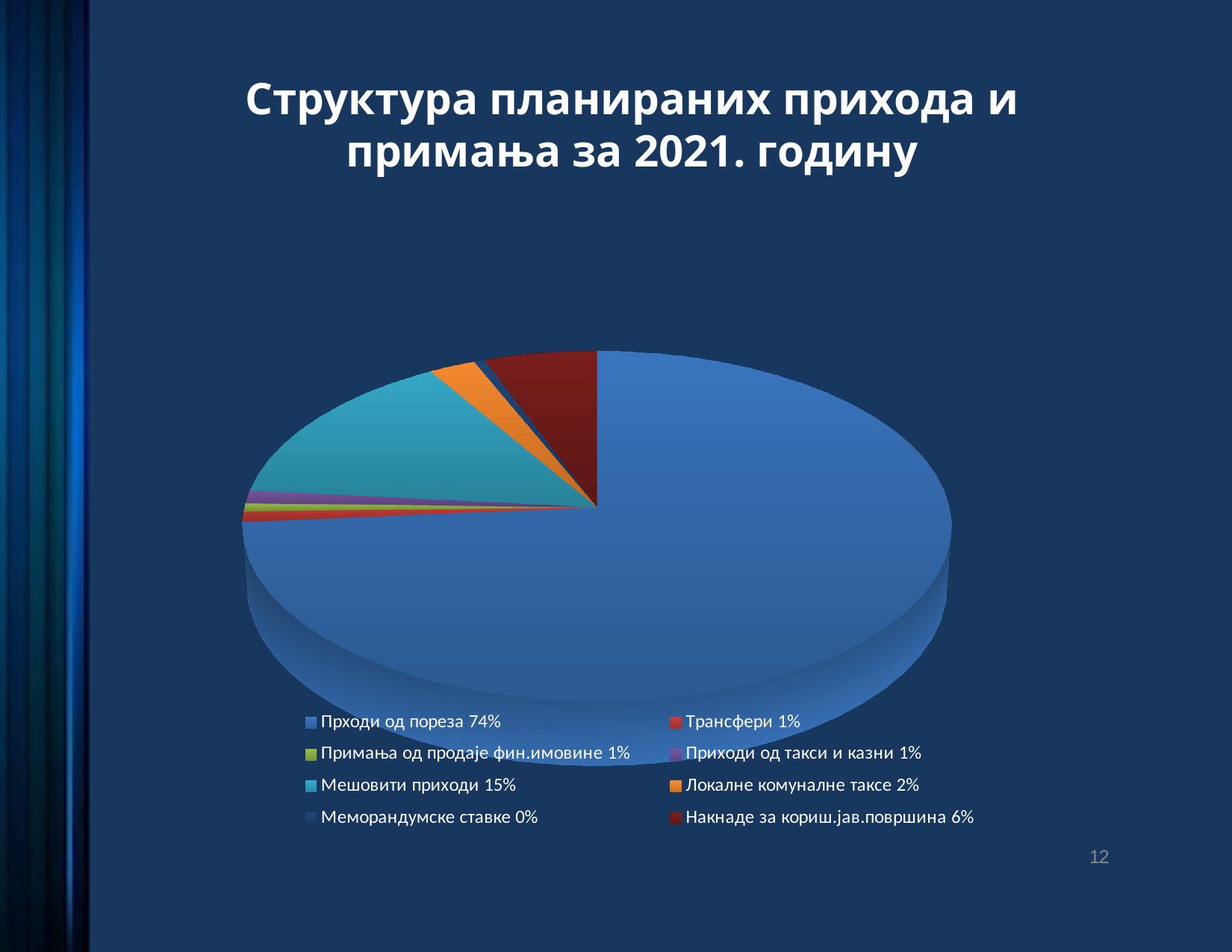
Which category has the largest share of the pie? Прходи од пореза What is the value shown for Накнаде за кориш.јав.површина? 6% What is the value shown for Локалне комуналне таксе? 2% What kind of chart is shown on the slide? pie chart What share of the pie does Мешовити приходи represent? 15% What is the value shown for Меморандумске ставке? 0% What share of the pie does Прходи од пореза represent? 74% What is the title of the slide containing the chart? Структура планираних прихода и примања за 2021. годину What is the difference between the shares of Прходи од пореза and Мешовити приходи? 59% Which category has the smallest share of the pie? Меморандумске ставке Which is larger, the share for Накнаде за кориш.јав.површина or the share for Локалне комуналне таксе? Накнаде за кориш.јав.површина How many categories does the legend list? 8